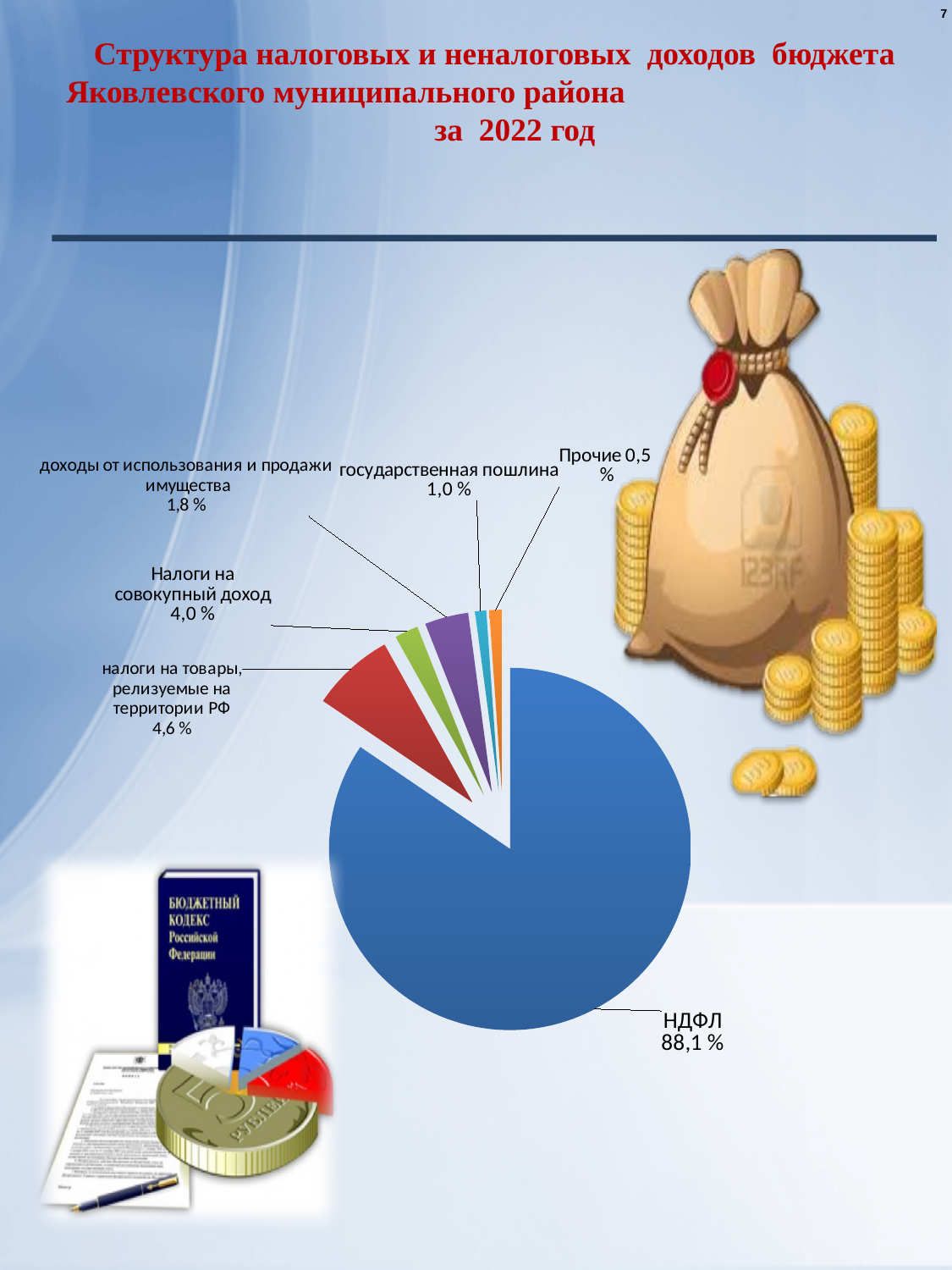
What is the value shown for налоги на товары, реализуемые на территории РФ? 4,6 % What type of chart is shown on the slide? pie chart What is the value shown for доходы от использования и продажи имущества? 1,8 % What share of the pie does НДФЛ account for? 88,1 % What is the value shown for Прочие? 0,5 % What is the value shown for Налоги на совокупный доход? 4,0 % Which category has the smallest slice of the pie? Прочие Which category has the largest slice of the pie? НДФЛ What is the value shown for государственная пошлина? 1,0 % Which is larger: the share of Налоги на совокупный доход or the share of государственная пошлина? Налоги на совокупный доход How many slices does the pie chart have? 6 What is the difference between the share of НДФЛ and the share of налоги на товары, реализуемые на территории РФ? 83,5 %